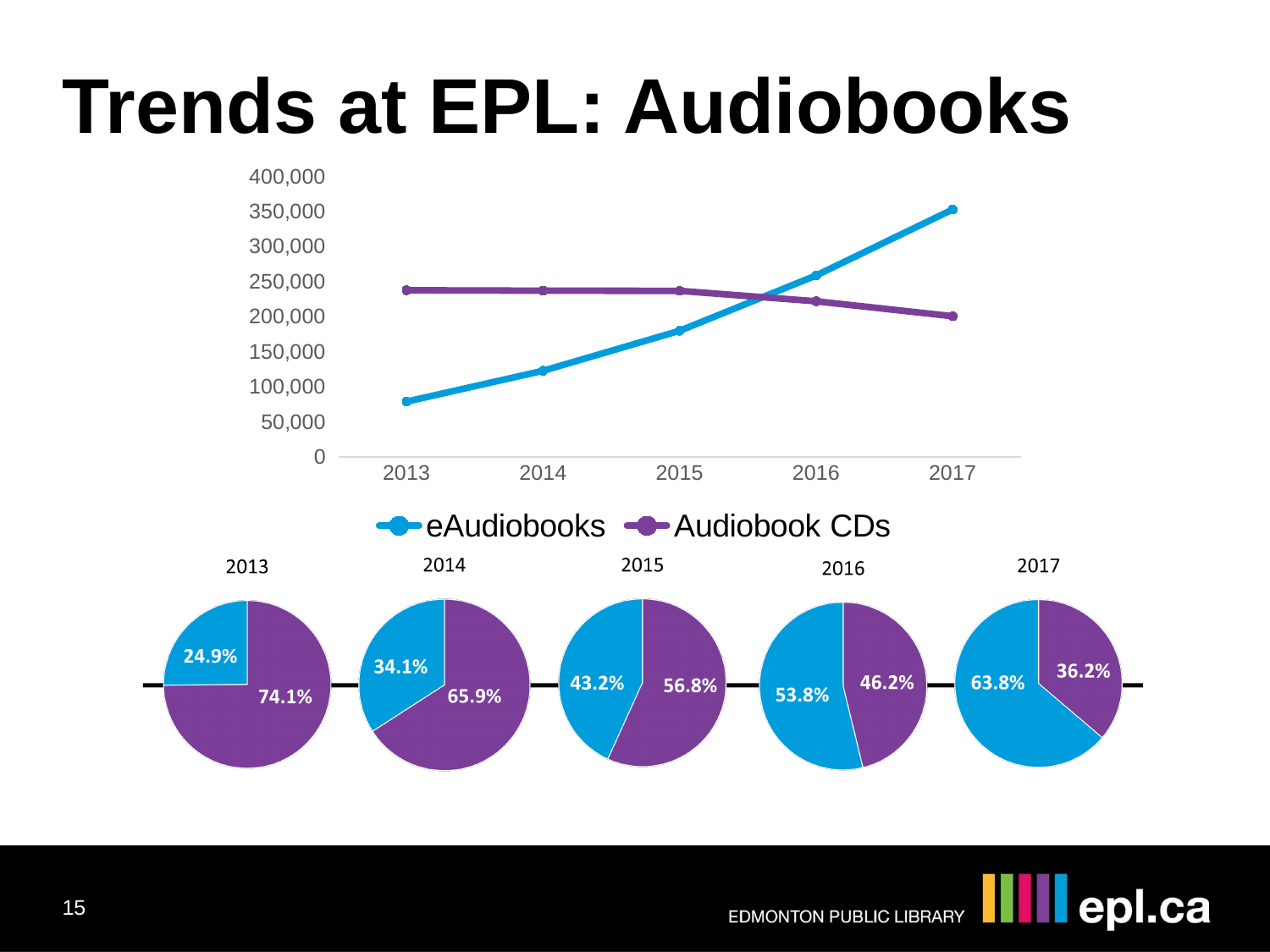
What kind of chart is the top chart on the slide? line chart In the 2015 pie chart, what share is shown for the blue (eAudiobooks) slice? 43.2% In the line chart, is the eAudiobooks value for 2013 greater or less than 100,000? less In the line chart, how many series does the legend list? 2 In the line chart, is the Audiobook CDs value for 2013 greater or less than 250,000? less In the line chart, do the eAudiobooks values rise or fall from 2013 to 2017? rise In the line chart, how many years are plotted along the x axis? 5 In the line chart, is the eAudiobooks value for 2015 greater or less than 150,000? greater In the line chart, which series has the larger value in 2017, eAudiobooks or Audiobook CDs? eAudiobooks In the 2013 pie chart, what share is shown for the purple (Audiobook CDs) slice? 74.1% In the line chart, which series has the larger value in 2013, eAudiobooks or Audiobook CDs? Audiobook CDs In the 2017 pie chart, what share is shown for the purple (Audiobook CDs) slice? 36.2%